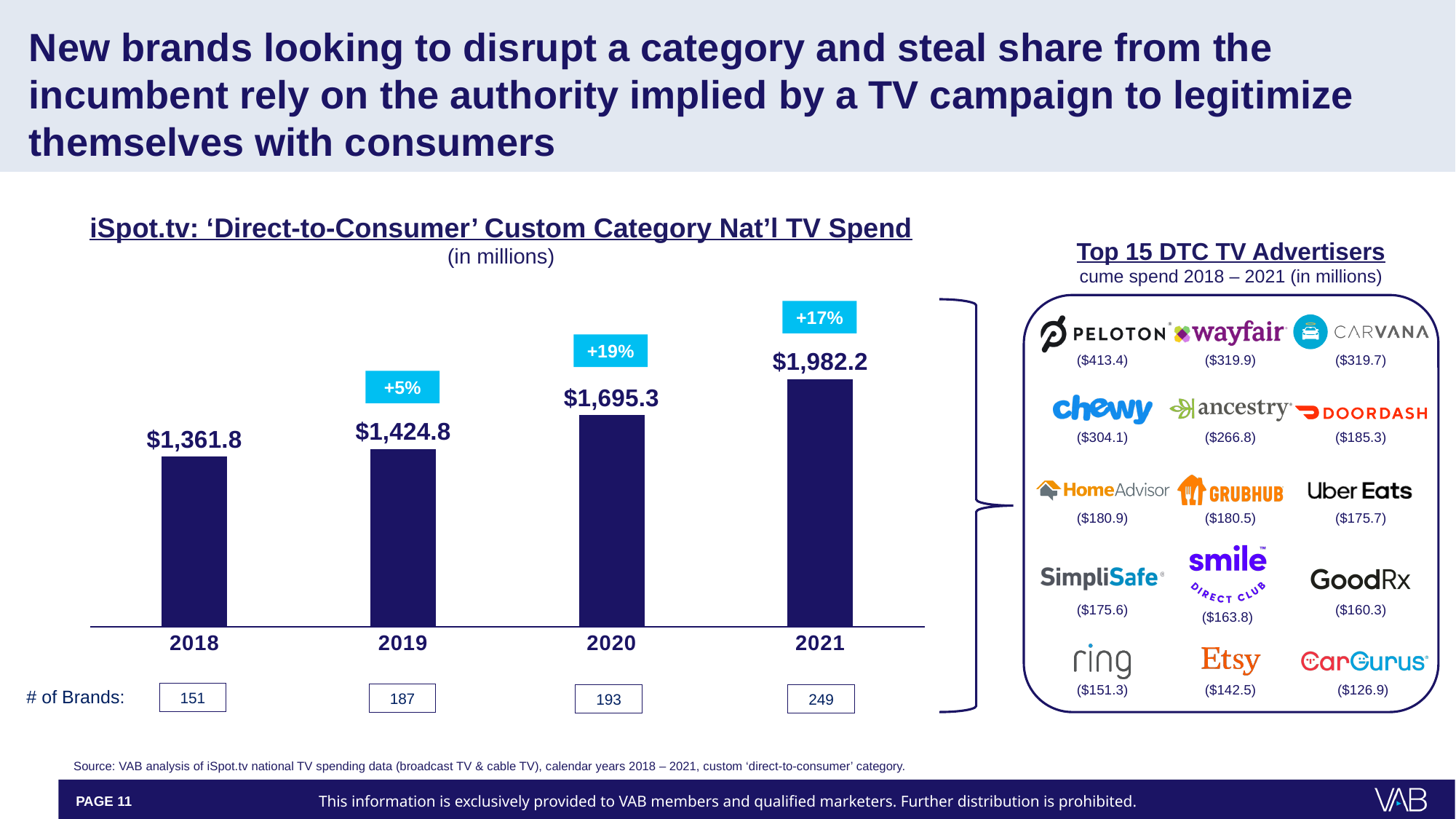
What is the difference in Direct-to-Consumer national TV spend between 2021 and 2020? $286.9 What was the Direct-to-Consumer national TV spend in 2018? $1,361.8 How many brands are listed for 2021 in the Direct-to-Consumer national TV spend chart? 249 Which year had the lowest Direct-to-Consumer national TV spend? 2018 What was the Direct-to-Consumer national TV spend in 2020? $1,695.3 Which year had a larger Direct-to-Consumer national TV spend, 2019 or 2020? 2020 What was the Direct-to-Consumer national TV spend in 2021? $1,982.2 How many years are shown in the Direct-to-Consumer national TV spend chart? 4 Does Direct-to-Consumer national TV spend rise or fall from 2018 to 2021? Rise Which year had the highest Direct-to-Consumer national TV spend? 2021 What percentage growth in Direct-to-Consumer national TV spend is shown for 2020? +19% What kind of chart is used to show Direct-to-Consumer national TV spend? Bar chart